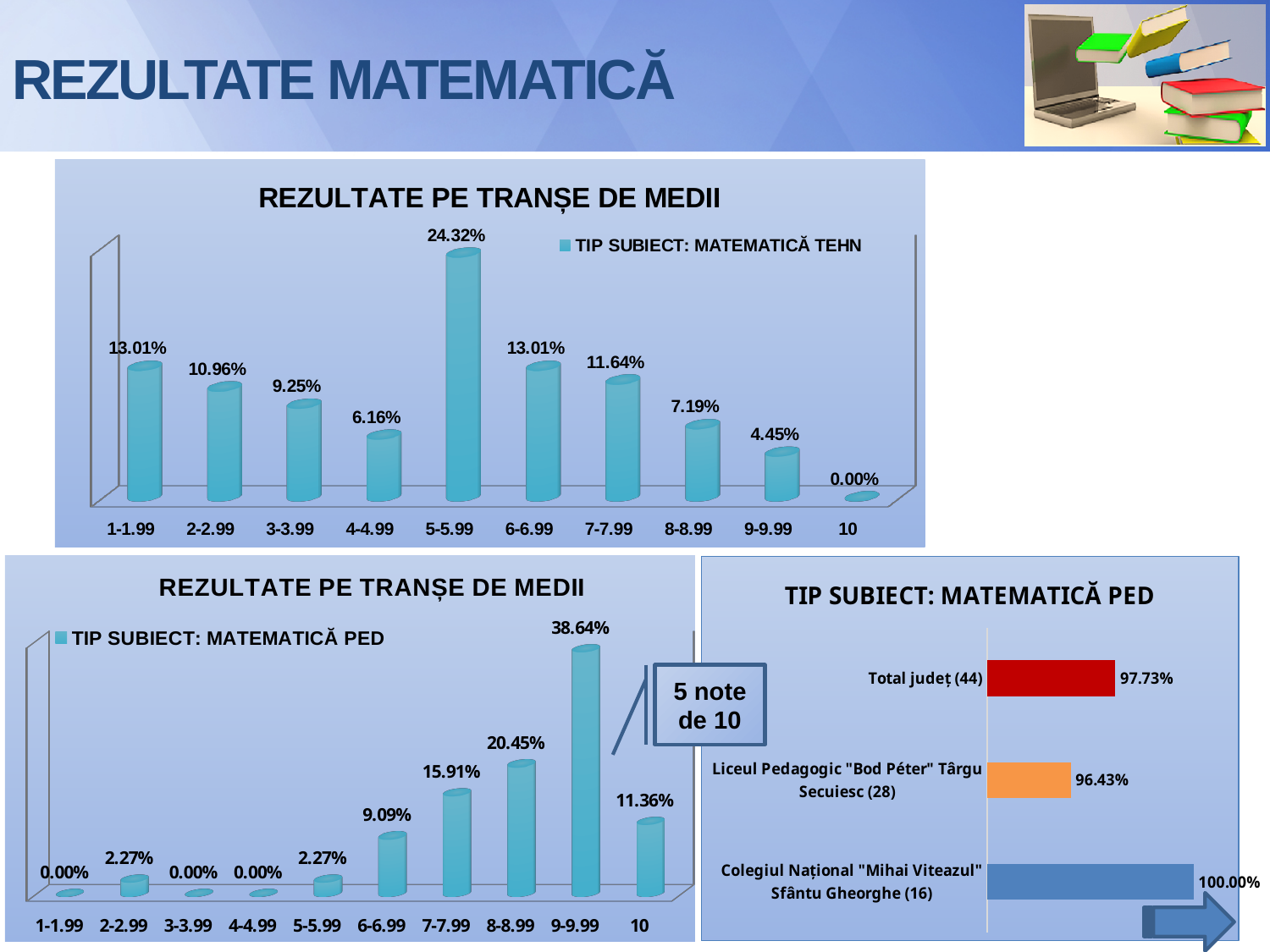
In the bottom-left chart (MATEMATICĂ PED), which range has the highest value? 9-9.99 In the top chart (MATEMATICĂ TEHN), how many ranges are shown on the x axis? 10 In the bottom-right chart (TIP SUBIECT: MATEMATICĂ PED), what is the value for Total județ (44)? 97.73% In the top chart (MATEMATICĂ TEHN), what is the value for the 5-5.99 range? 24.32% In the top chart (MATEMATICĂ TEHN), what is the value for the 9-9.99 range? 4.45% In the bottom-left chart (MATEMATICĂ PED), what is the value for the 9-9.99 range? 38.64% In the bottom-right chart (TIP SUBIECT: MATEMATICĂ PED), which school has the lowest value? Liceul Pedagogic "Bod Péter" Târgu Secuiesc (28) In the top chart (MATEMATICĂ TEHN), which range has the highest value? 5-5.99 In the bottom-left chart (MATEMATICĂ PED), which is larger: the value for 7-7.99 or for 8-8.99? 8-8.99 In the top chart (MATEMATICĂ TEHN), what is the difference between the values for 1-1.99 and 2-2.99? 2.05% In the bottom-left chart (MATEMATICĂ PED), what is the value for the 10 range? 11.36% What kind of chart is the bottom-right chart (TIP SUBIECT: MATEMATICĂ PED)? Bar chart